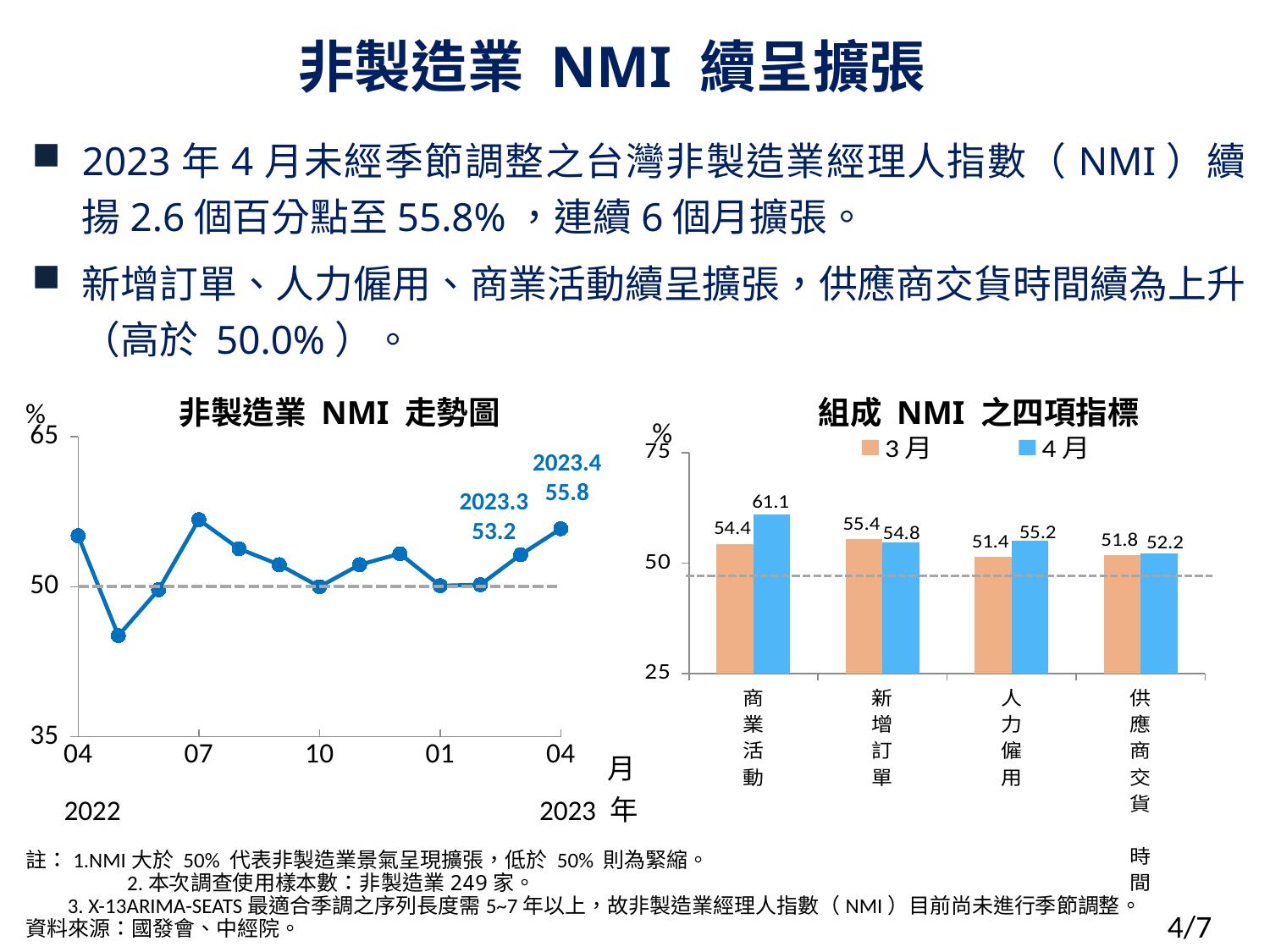
In the chart titled 組成 NMI 之四項指標, which category has the lowest 3月 value? 人力僱用 In the chart titled 非製造業 NMI 走勢圖, what is the value labelled for 2023.4? 55.8 In the chart titled 組成 NMI 之四項指標, how many categories are shown on the x axis? 4 In the chart titled 組成 NMI 之四項指標, what is the value for 新增訂單 in the 3月 series? 55.4 In the chart titled 組成 NMI 之四項指標, what is the difference between the 4月 and 3月 values for 商業活動? 6.7 In the chart titled 組成 NMI 之四項指標, what is the value for 商業活動 in the 4月 series? 61.1 What kind of chart is the chart titled 非製造業 NMI 走勢圖? line chart In the chart titled 組成 NMI 之四項指標, which is larger for 新增訂單: the 3月 value or the 4月 value? 3月 In the chart titled 非製造業 NMI 走勢圖, what is the value labelled for 2023.3? 53.2 In the chart titled 組成 NMI 之四項指標, how many series does the legend list? 2 In the chart titled 非製造業 NMI 走勢圖, is the value for 2022-05 (the second point) greater or less than 50? less In the chart titled 組成 NMI 之四項指標, which category has the highest 4月 value? 商業活動